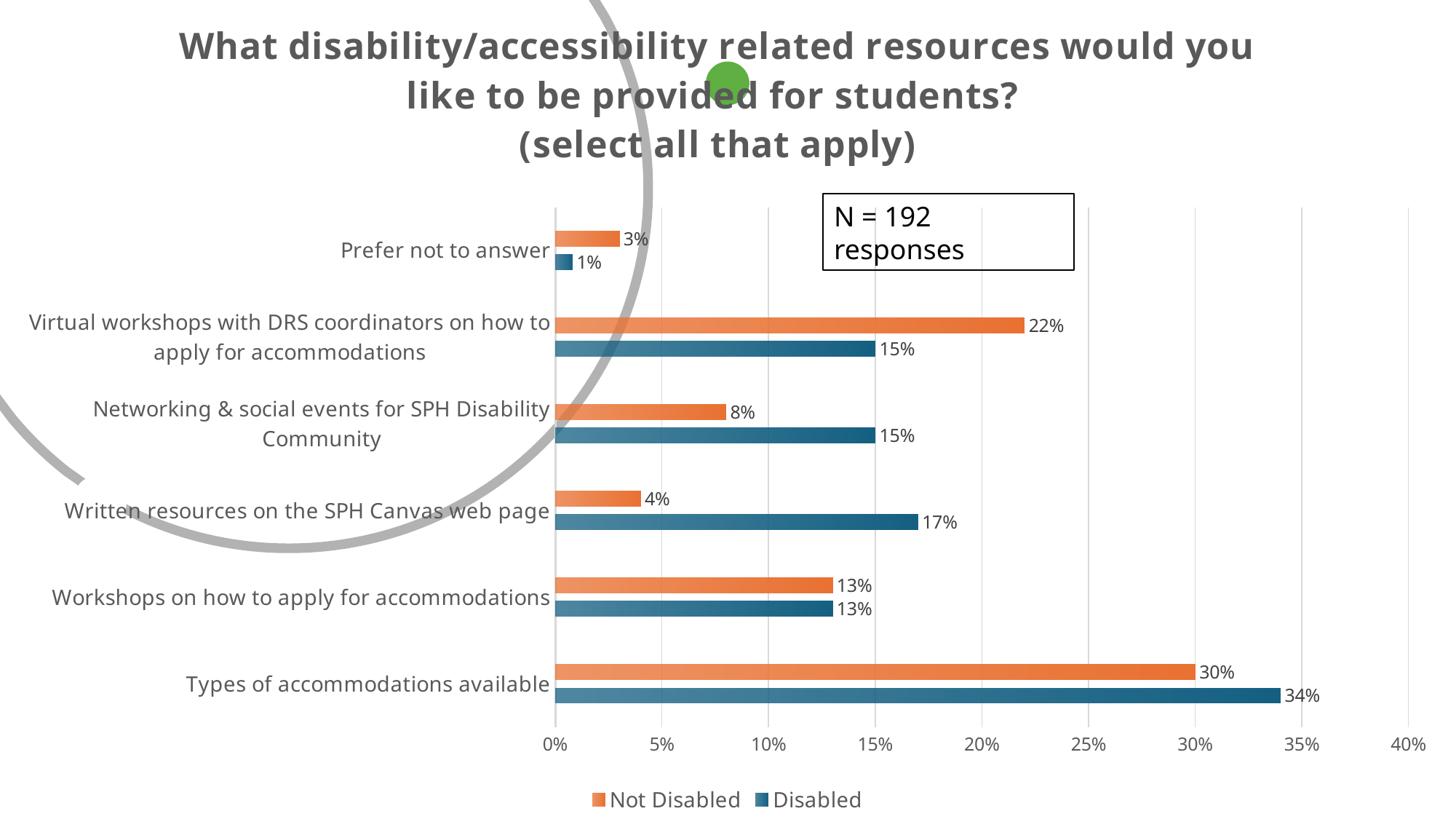
Which category has the lowest Disabled value? Prefer not to answer What is the difference between the Not Disabled and Disabled values for Networking & social events for SPH Disability Community? 7% How many series does the legend list? 2 Which category has the highest Not Disabled value? Types of accommodations available What kind of chart is shown on the slide? Bar chart What is the Not Disabled value for Virtual workshops with DRS coordinators on how to apply for accommodations? 22% For Written resources on the SPH Canvas web page, which series has the larger value, Not Disabled or Disabled? Disabled How many responses does the chart note say were collected? N = 192 responses What is the Not Disabled value for Prefer not to answer? 3% What is the Disabled value for Written resources on the SPH Canvas web page? 17% What is the Disabled value for Types of accommodations available? 34% How many categories are shown on the chart? 6